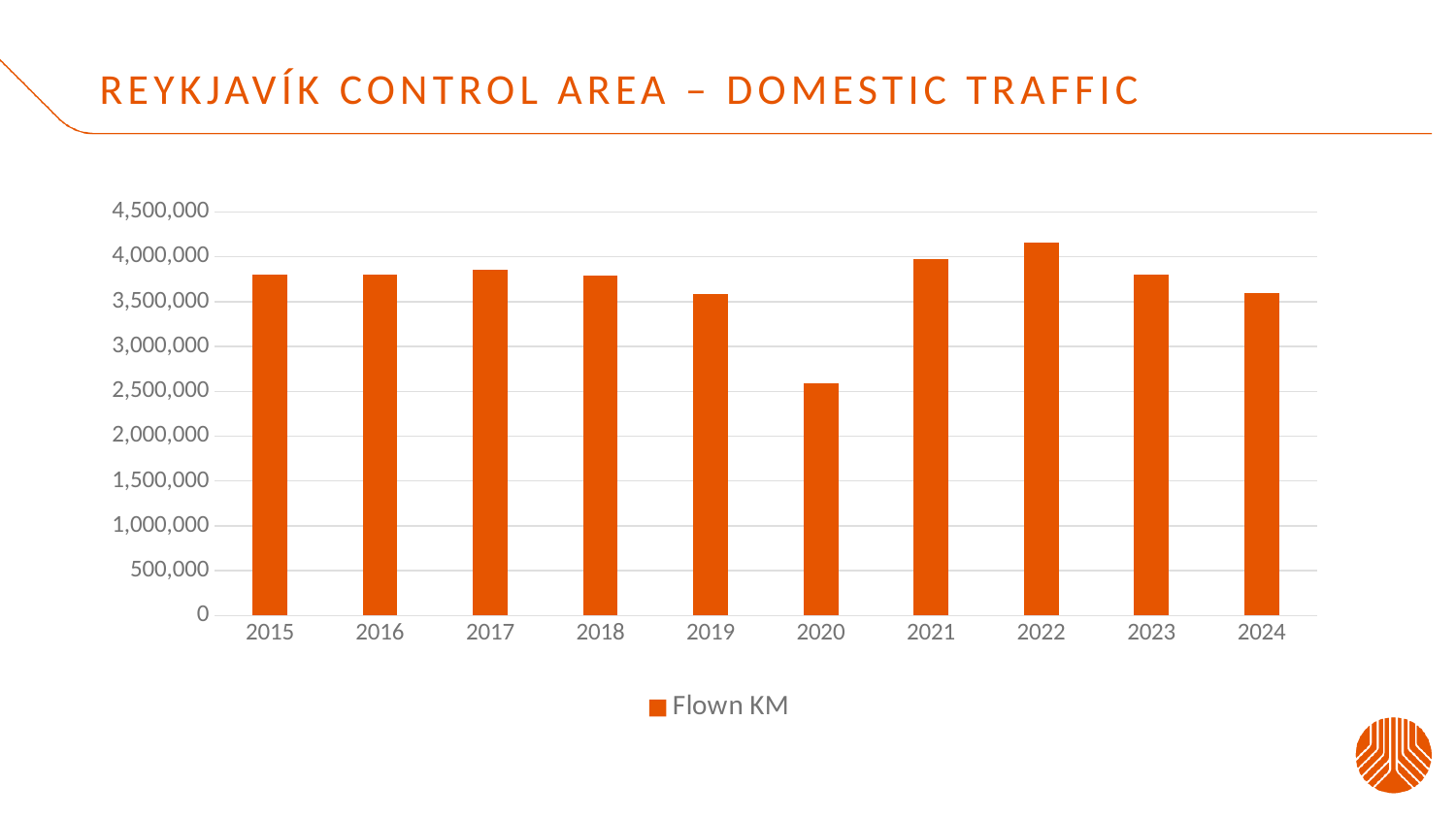
Is the Flown KM value for 2015 greater or less than 3,500,000? greater What is the title of the slide? Reykjavík Control Area – Domestic Traffic Is the Flown KM value for 2020 greater or less than 3,000,000? less How many series does the legend list? 1 What is the name of the series shown in the legend? Flown KM Which year has the larger Flown KM value, 2021 or 2019? 2021 Do the Flown KM values rise or fall from 2022 to 2024? fall What kind of chart is shown on the slide? Bar chart Is the Flown KM value for 2022 greater or less than 4,000,000? greater Which year has the highest Flown KM value? 2022 How many years are shown on the x axis of the chart? 10 Which year has the lowest Flown KM value? 2020